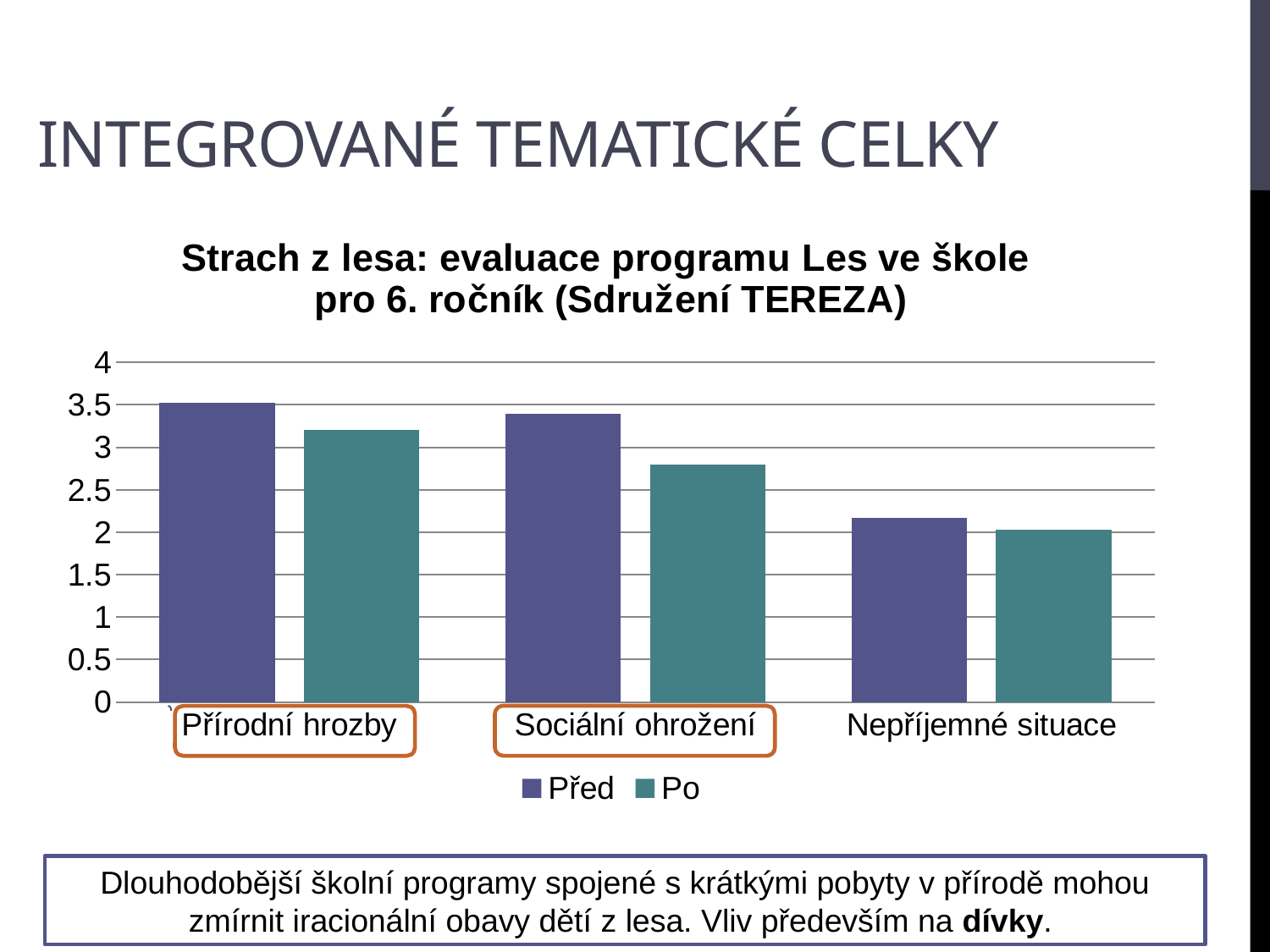
How many categories are shown on the x axis of the chart? 3 Is the Před value for Přírodní hrozby greater or less than 3? greater Which category has the highest value for the Po series? Přírodní hrozby How many series does the chart legend list? 2 Which category has the lowest value for the Po series? Nepříjemné situace What kind of chart is shown on the slide? bar chart Is the Po value for Sociální ohrožení greater or less than 3? less Which category has the lowest value for the Před series? Nepříjemné situace Is the Po value for Nepříjemné situace greater or less than 2.5? less What are the two series named in the chart legend? Před and Po Do the Po values rise or fall moving from left to right across the categories? fall For Sociální ohrožení, which is larger: the Před value or the Po value? Před